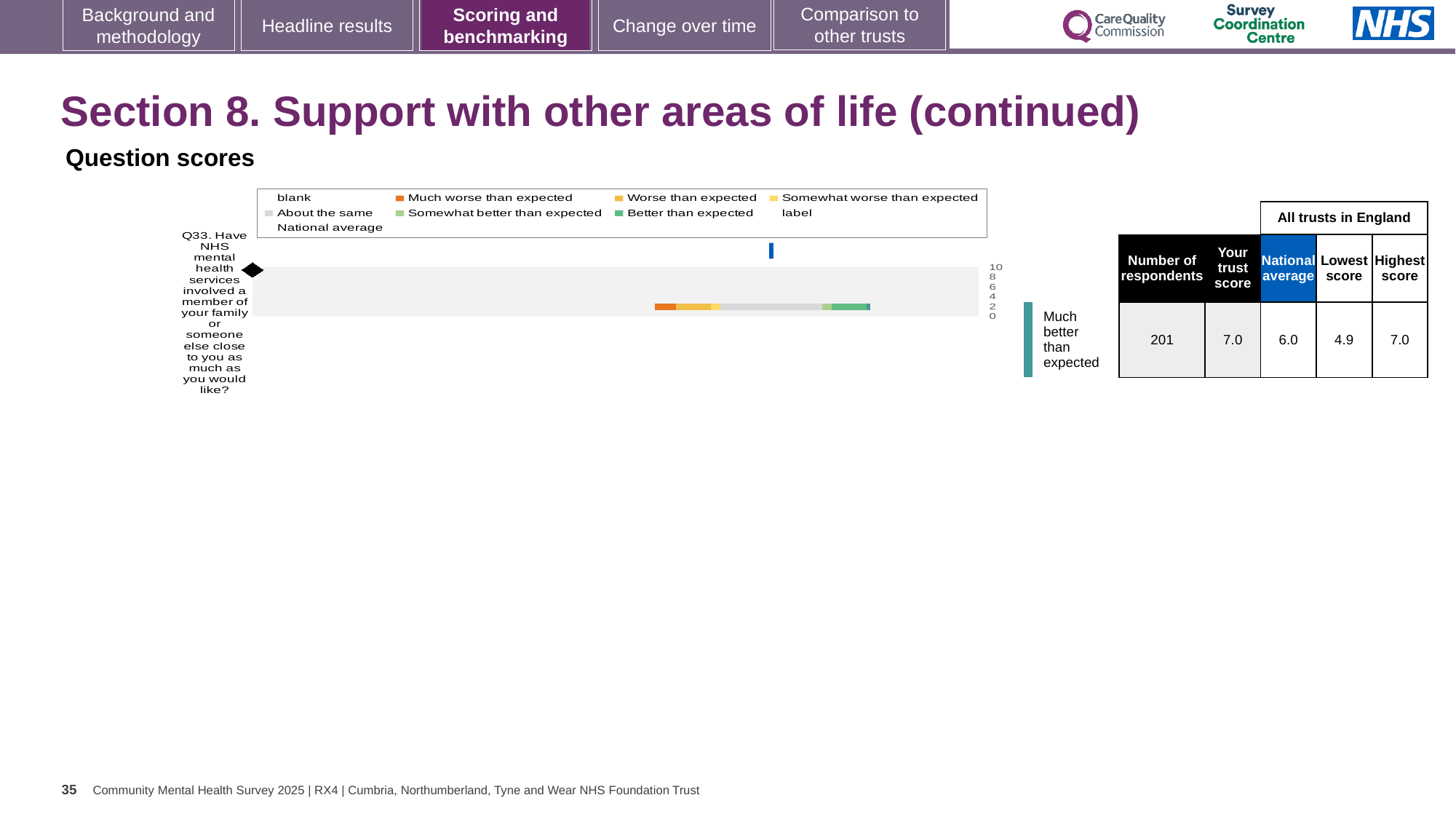
What is the Highest score among all trusts in England for Q33? 7.0 What is the National average score for Q33? 6.0 What is the 'Your trust score' for Q33? 7.0 What is the Lowest score among all trusts in England for Q33? 4.9 What kind of chart is shown on the slide? bar chart How many questions are plotted in the chart? 1 What is the benchmark category label shown next to the chart for Q33? Much better than expected How many respondents answered Q33? 201 Which question is plotted in the chart? Q33. Have NHS mental health services involved a member of your family or someone else close to you as much as you would like? What is the highest value shown on the chart's score axis? 10 What is the difference between the trust score and the National average for Q33? 1.0 Which is larger for Q33, the trust score or the National average? trust score